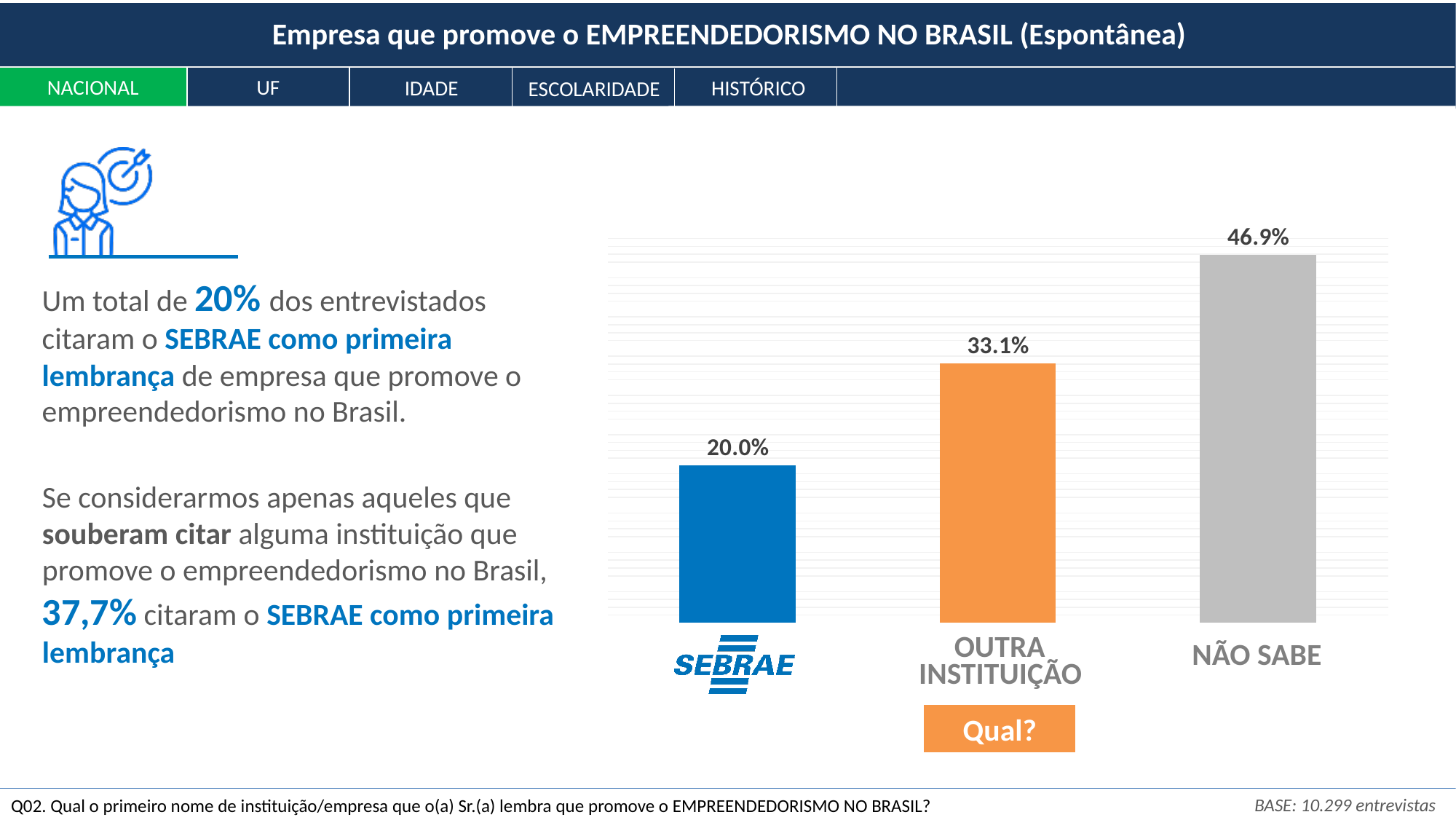
What kind of chart is shown on the slide? Bar chart Which category has the lowest value? SEBRAE What is the value shown for OUTRA INSTITUIÇÃO? 33.1% Do the values rise or fall from left to right across the categories? Rise Which category has the highest value? NÃO SABE Which is larger, the value for SEBRAE or the value for OUTRA INSTITUIÇÃO? OUTRA INSTITUIÇÃO What is the difference between the values for NÃO SABE and SEBRAE? 26.9% How many categories are shown in the chart? 3 What is the value shown for SEBRAE? 20.0% What is the difference between the values for OUTRA INSTITUIÇÃO and SEBRAE? 13.1% What is the value shown for NÃO SABE? 46.9% What is the difference between the values for NÃO SABE and OUTRA INSTITUIÇÃO? 13.8%